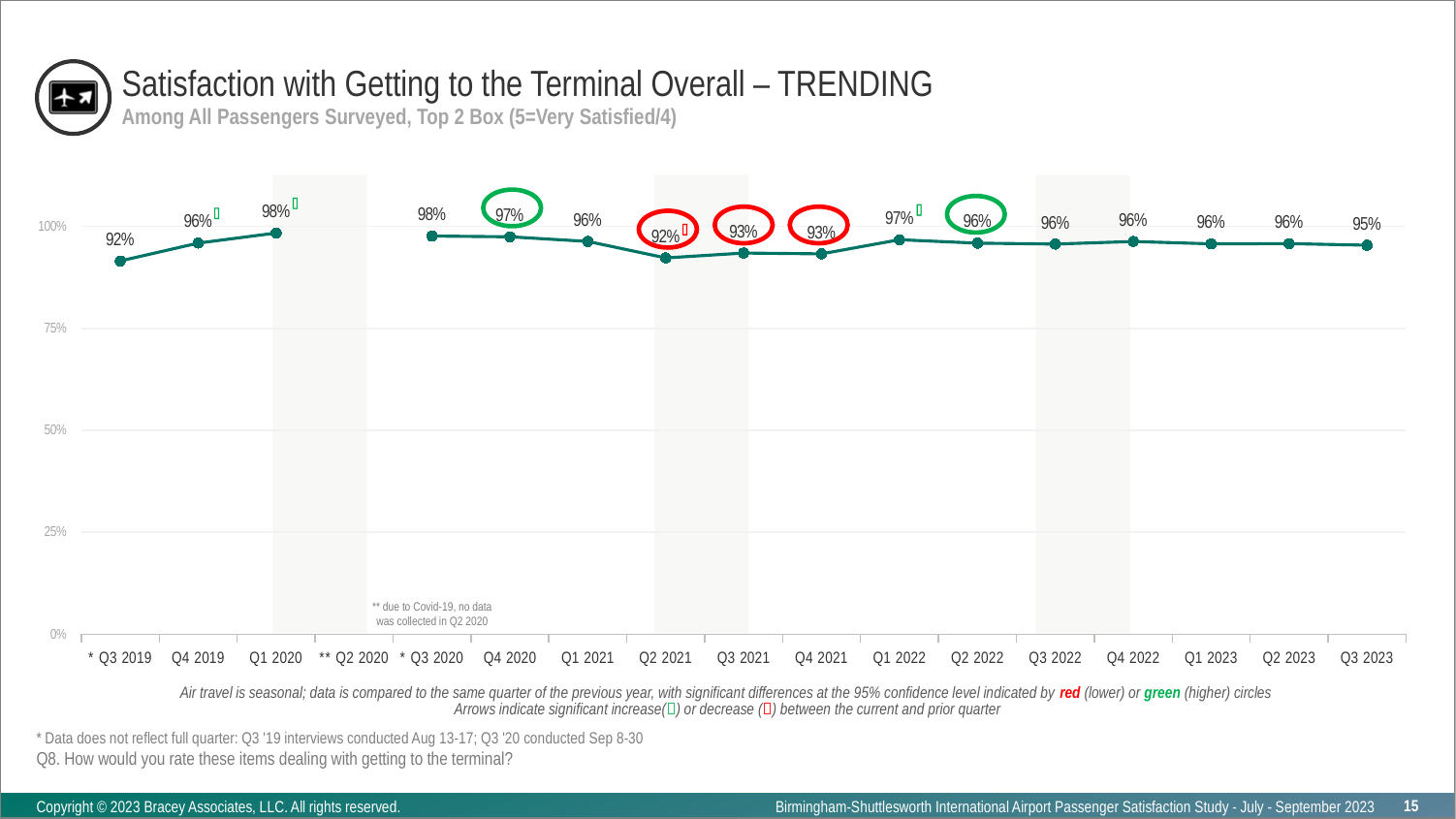
What kind of chart is shown on the slide? line chart Which quarter has the higher value, Q1 2022 or Q2 2022? Q1 2022 What does a red circle around a data point indicate? significantly lower than the same quarter of the previous year What is the satisfaction value for Q2 2021? 92% Do the values rise or fall from Q3 2019 to Q1 2020? rise What is the satisfaction value for Q1 2022? 97% What is the highest satisfaction value shown on the chart? 98% Is the value for Q4 2021 greater or less than 75%? greater What is the satisfaction value for Q3 2023? 95% What is the lowest satisfaction value shown on the chart? 92% Which quarter on the x axis has no data plotted? Q2 2020 What is the difference between the values for Q1 2020 and Q3 2019? 6 percentage points